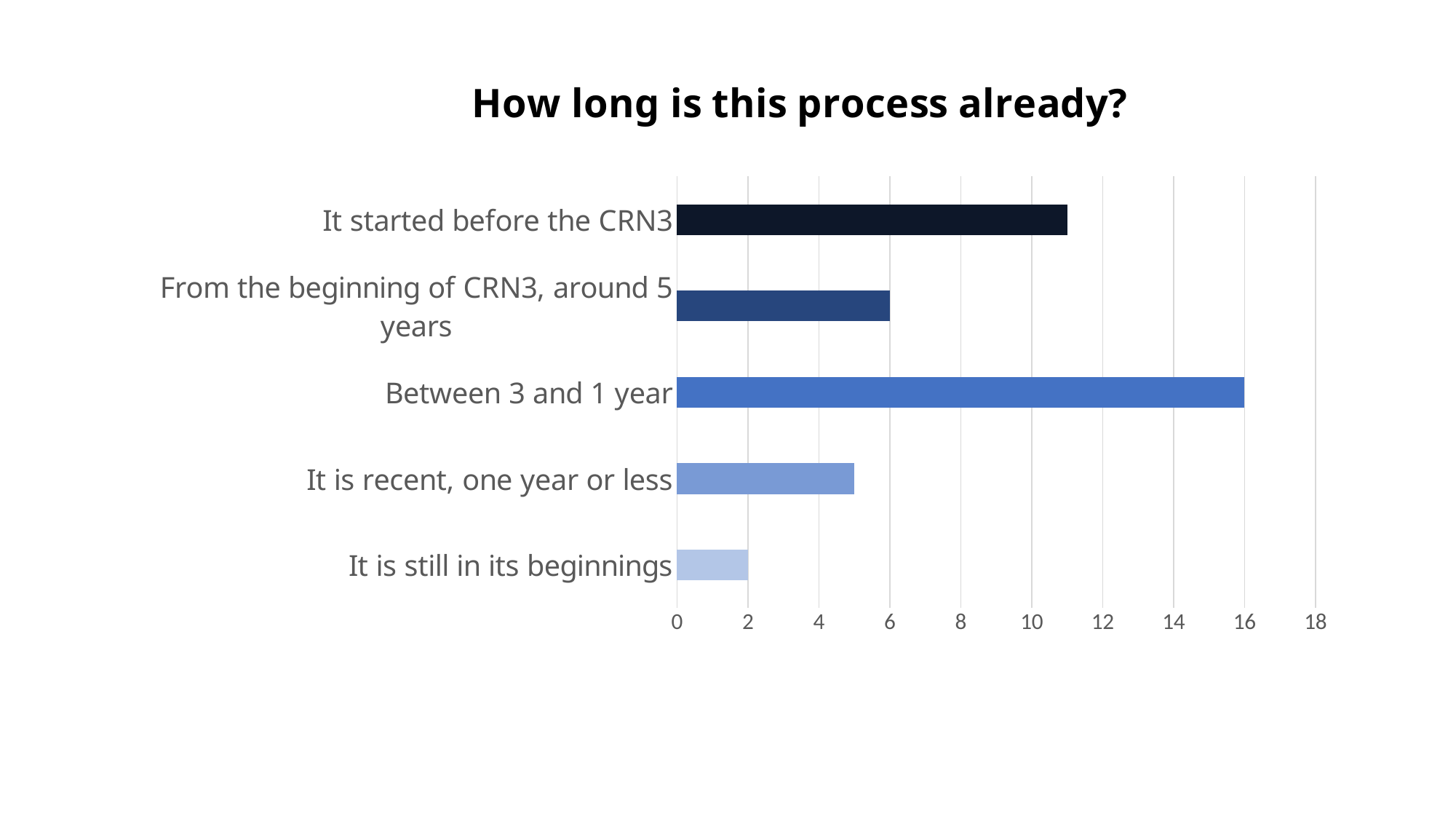
Is the value for "It is recent, one year or less" greater or less than 6? less What is the value for "It is still in its beginnings"? 2 What type of chart is shown on the slide? bar chart Which category has the highest value? Between 3 and 1 year What is the value for "Between 3 and 1 year"? 16 How many categories are shown in the chart? 5 What is the value for "From the beginning of CRN3, around 5 years"? 6 Which category has the lowest value? It is still in its beginnings What is the title of the chart? How long is this process already? Is the value for "It started before the CRN3" greater or less than 10? greater What is the difference between the values for "Between 3 and 1 year" and "From the beginning of CRN3, around 5 years"? 10 Which is larger, the value for "It started before the CRN3" or the value for "It is recent, one year or less"? It started before the CRN3